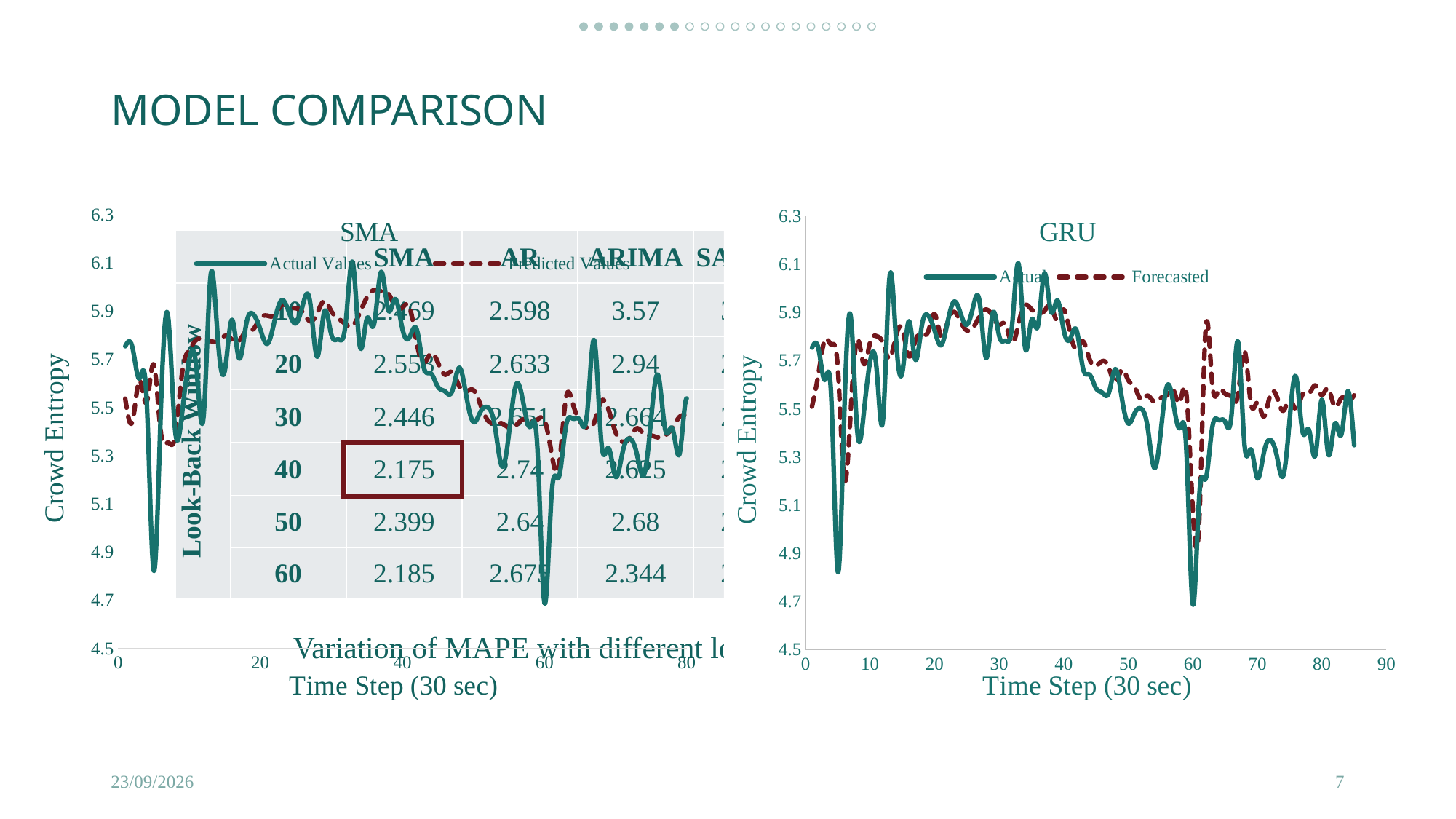
What kind of chart is the GRU chart on the right? line chart In the GRU chart, is the Actual value at time step 60 greater or less than 5.1? less In the GRU chart, is the Actual value at time step 33 greater or less than 5.9? greater How many series does the legend of the SMA chart list? 2 In the GRU chart, is the Actual value at time step 5 greater or less than 5.1? less In the GRU chart, what are the two series named in the legend? Actual and Forecasted In the GRU chart, at time step 60, which series has the larger value, Actual or Forecasted? Forecasted In the GRU chart, does the Forecasted line rise or fall between time step 40 and time step 55? fall In the SMA chart, what are the two series named in the legend? Actual Values and Predicted Values How many series does the legend of the GRU chart list? 2 What kind of chart is the SMA chart on the left? line chart